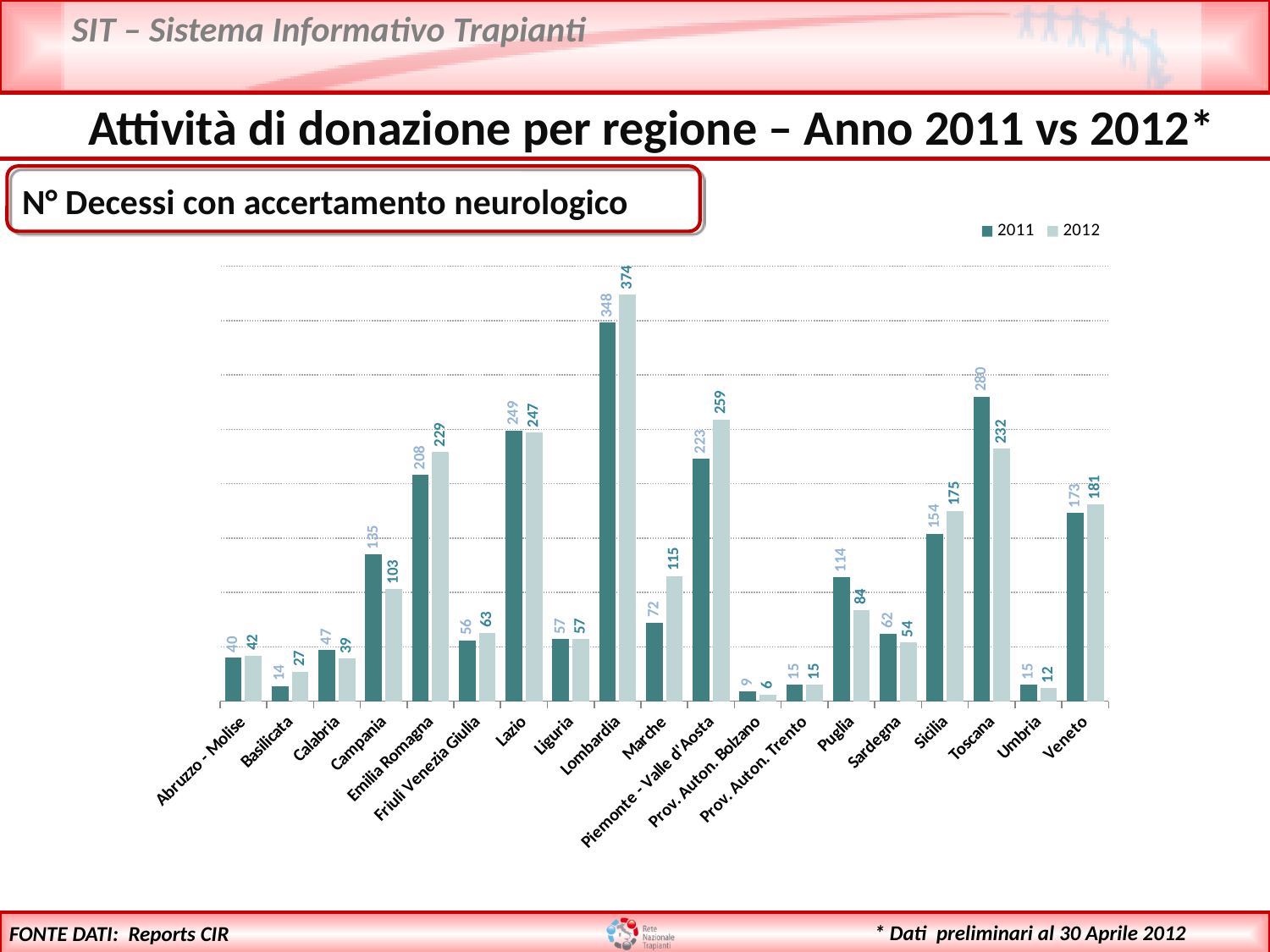
How many regions are shown on the x axis? 19 What is the difference between the 2012 and 2011 values for Lombardia? 26 What is the 2011 value for Lombardia? 348 Which is larger for Campania, the 2011 value or the 2012 value? 2011 What is the 2012 value for Piemonte - Valle d'Aosta? 259 Which region has the lowest 2011 value? Prov. Auton. Bolzano Which is larger for Sicilia, the 2011 value or the 2012 value? 2012 What is the 2012 value for Marche? 115 What kind of chart is shown on the slide? Bar chart How many series does the legend list? 2 Which region has the highest 2012 value? Lombardia What is the difference between the 2011 and 2012 values for Toscana? 48